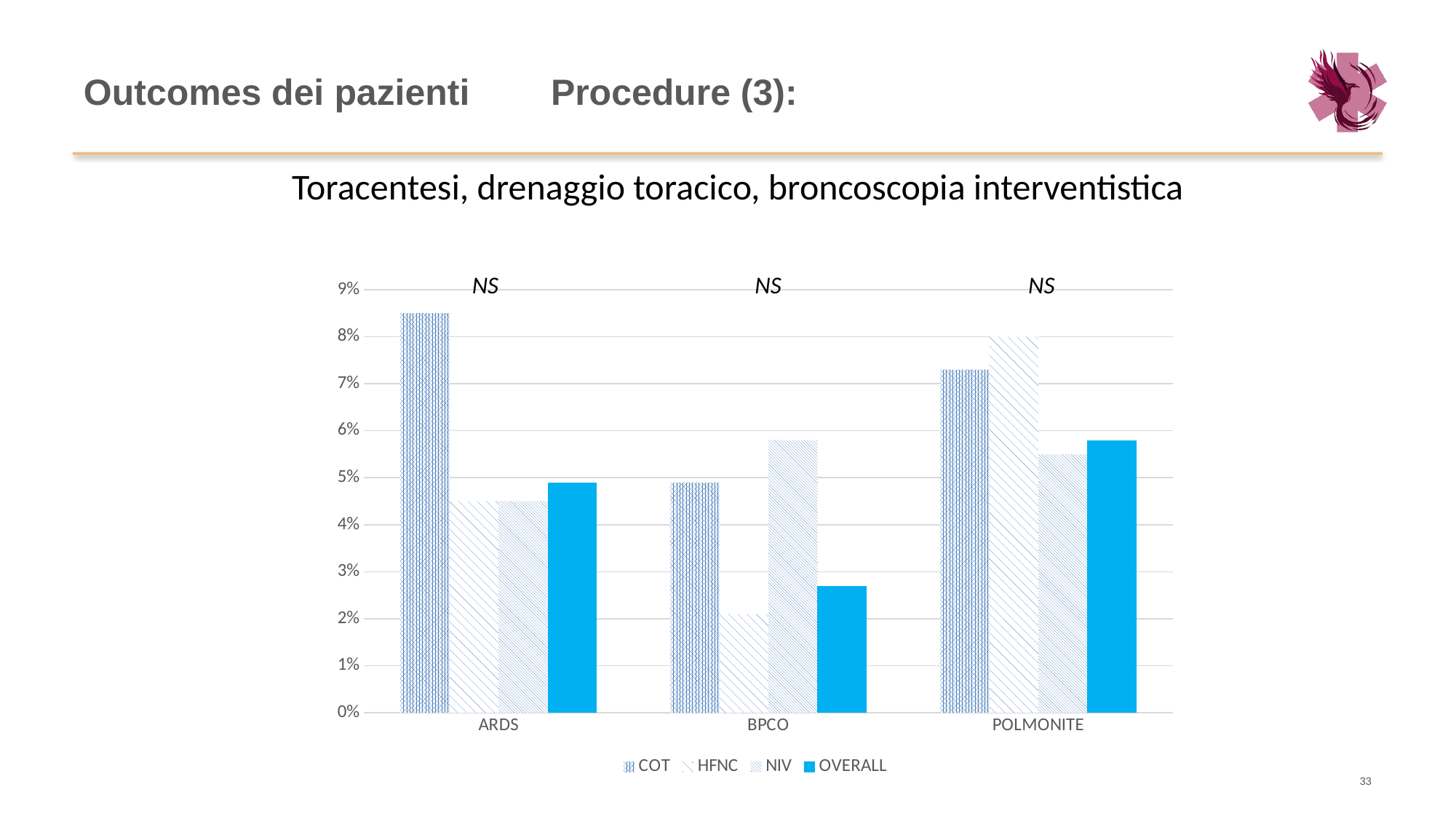
Is the OVERALL value for POLMONITE greater or less than 5%? greater Which series has the lowest value for BPCO? HFNC How many categories are shown on the x axis of the chart? 3 Which is larger: the COT value for ARDS or the COT value for POLMONITE? ARDS How many series does the chart legend list? 4 What kind of chart is shown on the slide? bar chart What annotation appears above each category group in the chart? NS Which series has the highest value for BPCO? NIV Is the OVERALL value for BPCO greater or less than 3%? less Which series has the highest value for ARDS? COT Which series has the highest value for POLMONITE? HFNC Is the COT value for ARDS greater or less than 8%? greater